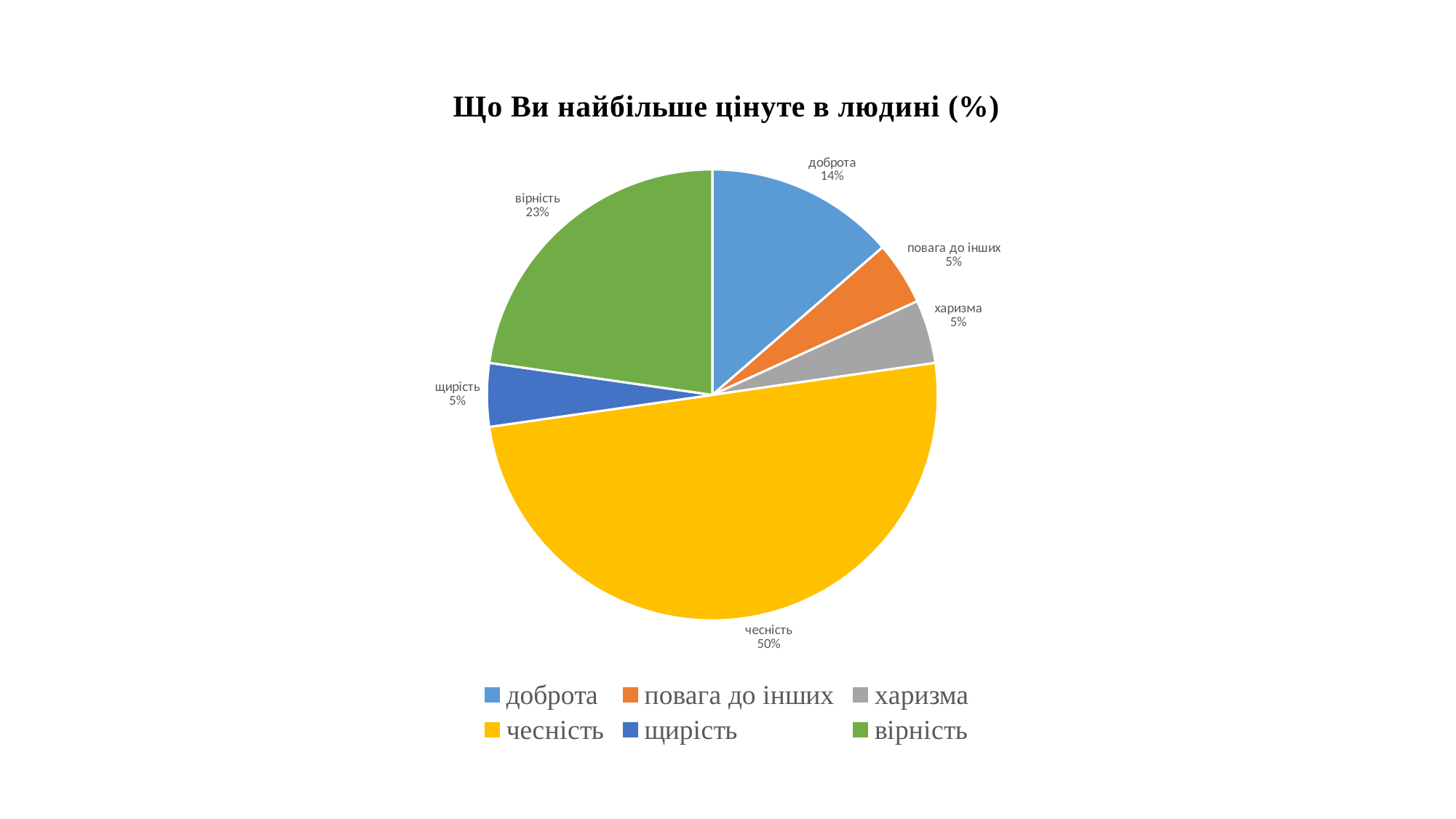
What is the difference between the values for вірність and доброта? 9% How many categories does the pie chart have? 6 Which category has the largest slice? чесність What is the difference between the values for чесність and вірність? 27% Which is larger, the value for доброта or the value for щирість? доброта What is the value for доброта? 14% What kind of chart is shown on the slide? pie chart What is the value for вірність? 23% What is the value for харизма? 5% What colour is the slice for чесність? yellow What is the title of the chart? Що Ви найбільше цінуте в людині (%) What share of the pie does чесність take? 50%